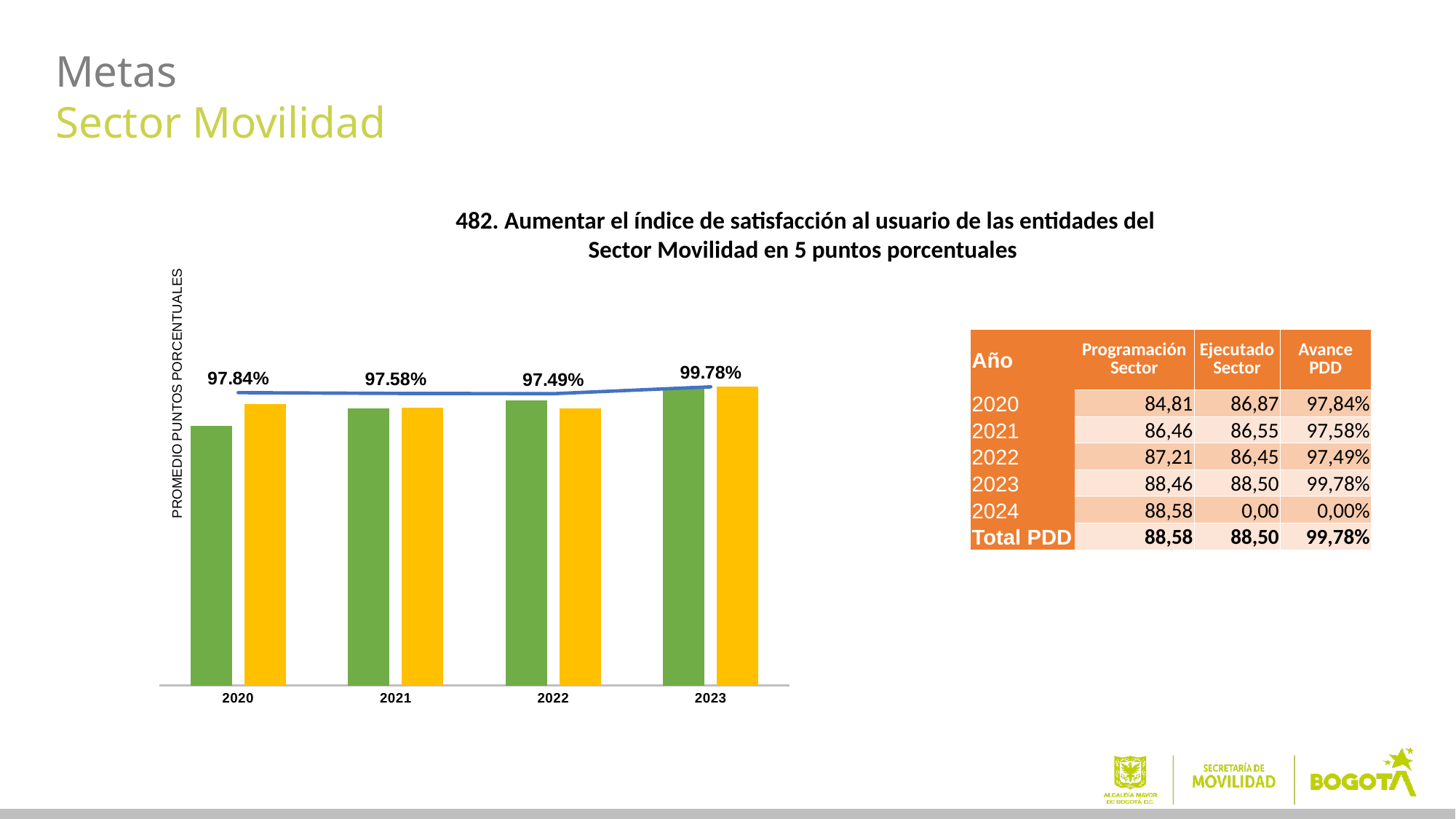
What number begins the chart title? 482 Which year has the lowest labelled value on the chart? 2022 What is the label on the vertical axis of the chart? PROMEDIO PUNTOS PORCENTUALES How many years are shown on the x axis of the chart? 4 What is the difference between the labelled values for 2023 and 2022? 2.29 percentage points Which is larger, the labelled value for 2020 or for 2021? 2020 Which year has the highest labelled value on the chart? 2023 What is the data label shown for 2022 on the chart? 97.49% What is the data label shown for 2023 on the chart? 99.78% What is the data label shown for 2020 on the chart? 97.84% What kind of chart is shown on the slide? Bar chart with a line Does the labelled value rise or fall from 2022 to 2023? Rise